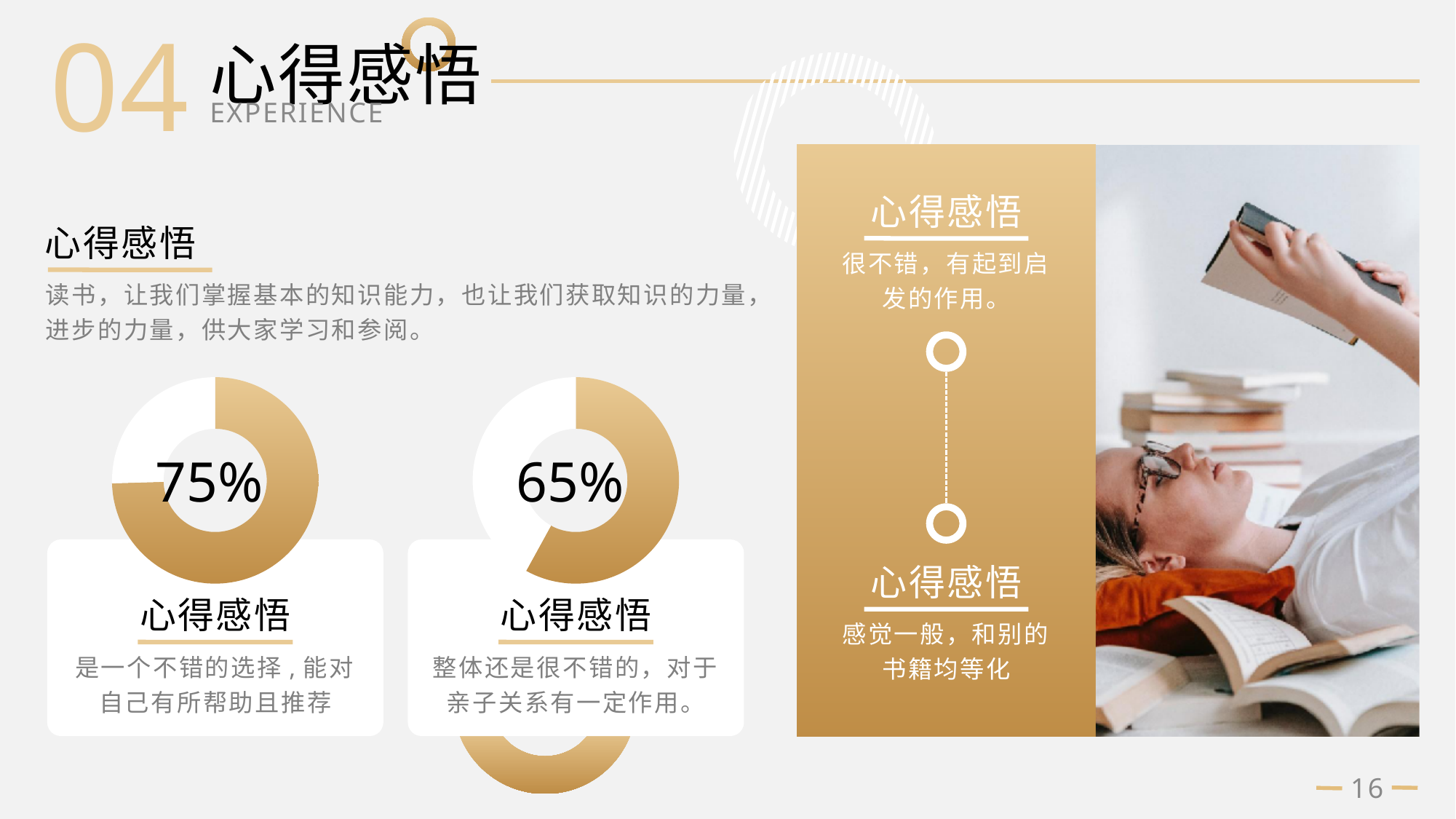
What percentage is shown in the right donut chart? 65% Which donut chart shows the larger percentage, the left one or the right one? the left one What percentage is shown in the left donut chart? 75% What kind of chart is used to display the 75% and 65% values? donut (pie) chart Is the value in the right donut chart greater or less than 50%? greater How many donut charts are on the slide? 2 What is the label printed beneath each donut chart? 心得感悟 What is the difference between the percentages shown in the left and right donut charts? 10% Which donut chart shows the smaller percentage, the left one or the right one? the right one In the left donut chart, what share of the ring is filled in gold? 75% What colour is the filled portion of the donut charts? gold